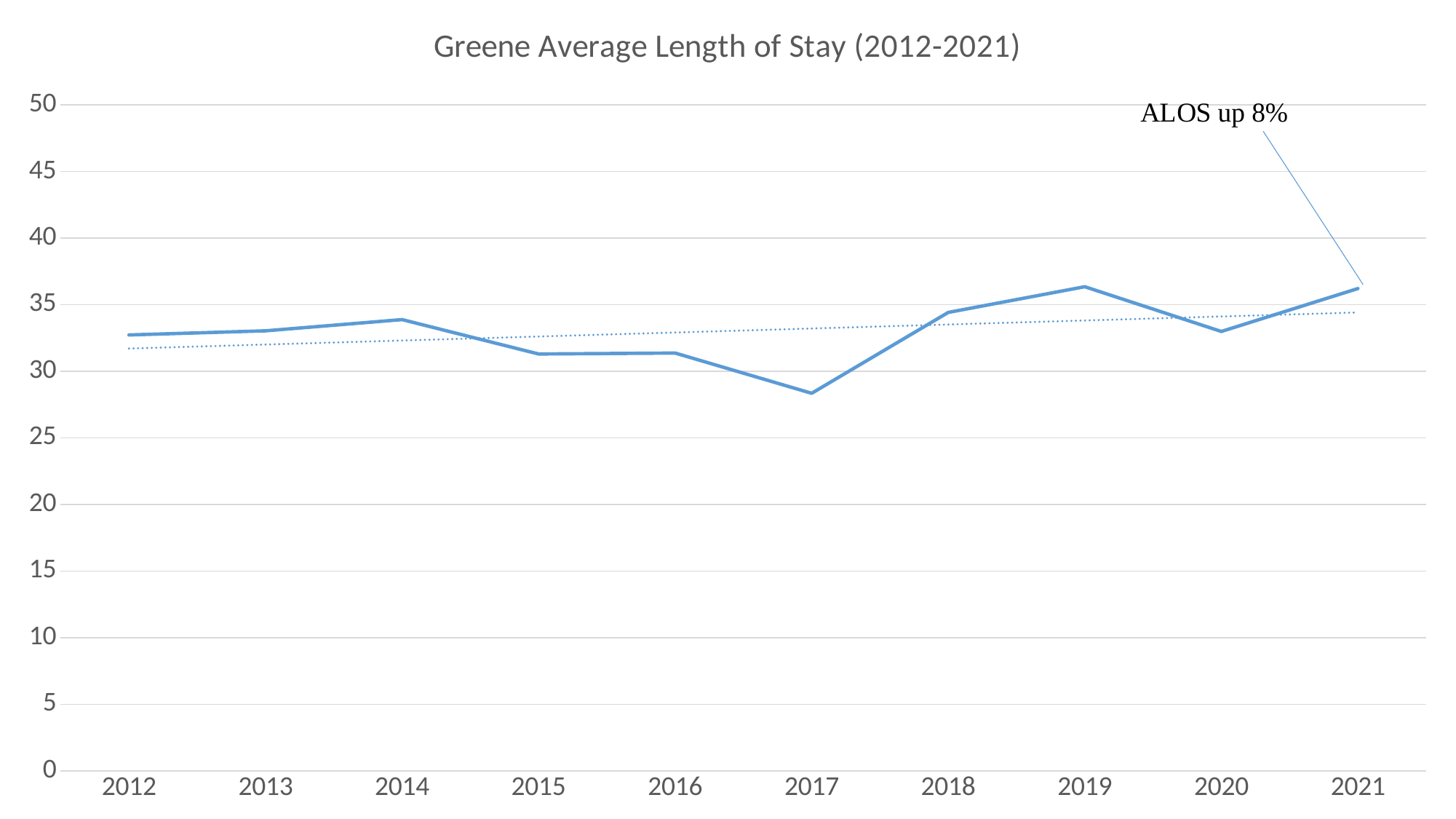
Is the value for 2017 greater or less than 30? less How many years are plotted along the x axis? 10 What does the annotation pointing to the 2021 data point say? ALOS up 8% Which year has the lowest average length of stay? 2017 What is the title of the chart? Greene Average Length of Stay (2012-2021) Is the value for 2019 greater or less than 35? greater Is the value for 2012 greater or less than 30? greater Do the values rise or fall from 2017 to 2019? rise Which year has the larger value, 2014 or 2015? 2014 Which year has the larger value, 2017 or 2018? 2018 What kind of chart is shown on the slide? line chart